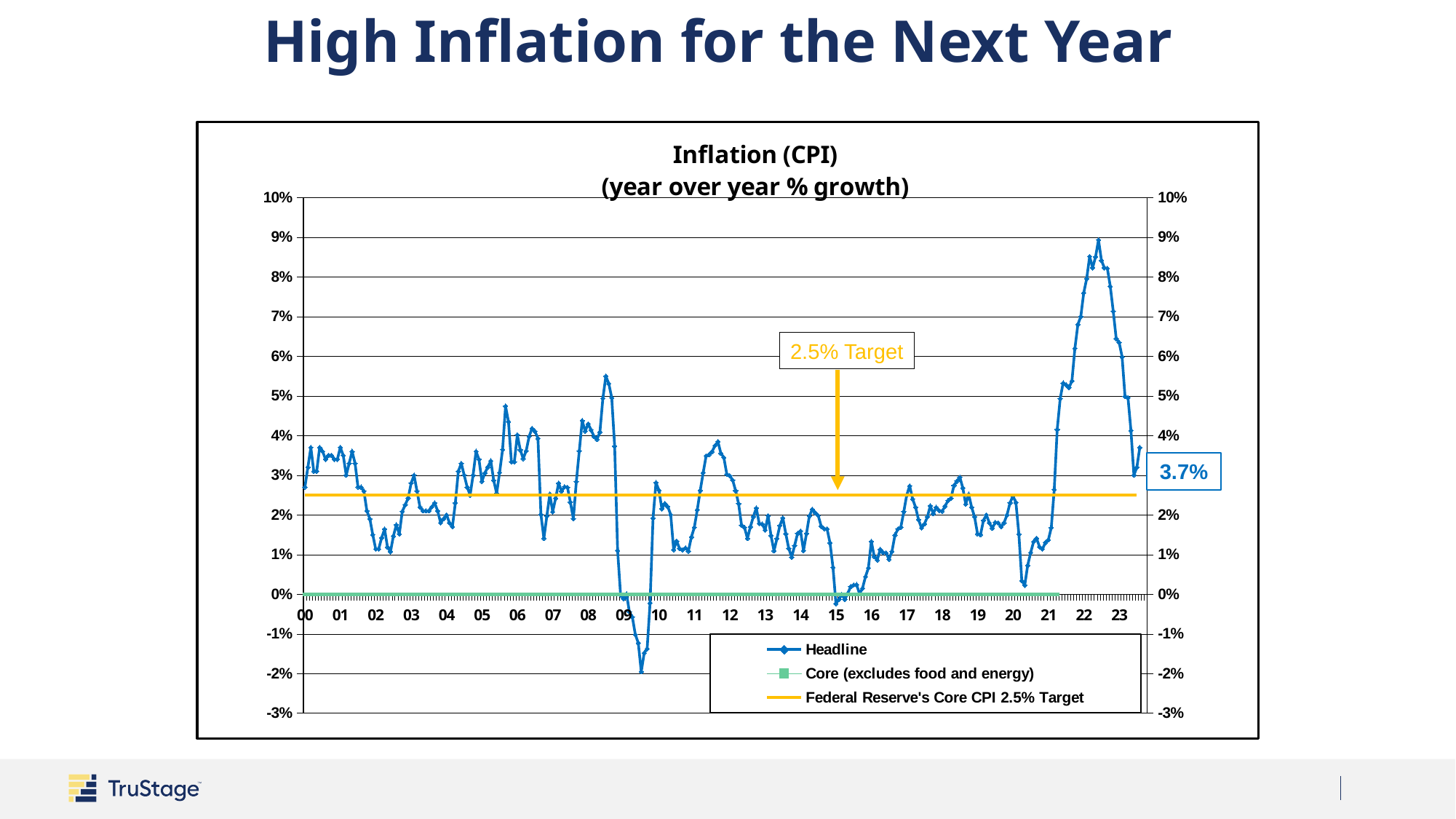
How many series does the chart's legend list? 3 What is the most recent Headline inflation value labelled on the chart? 3.7% What is the Federal Reserve's Core CPI target shown on the chart? 2.5% Does the Headline series rise or fall between its 2022 peak and the end of 2023? fall What is the title of the chart? Inflation (CPI) (year over year % growth) Which is larger, the latest labelled Headline inflation value or the Federal Reserve's target? Headline (3.7%) Is the peak Headline inflation value in 2022 greater or less than 8%? greater What kind of chart is shown on the slide? line chart Is the lowest Headline inflation value in 2009 greater or less than -1%? less In which year does the Headline series reach its highest point? 22 In which year does the Headline series reach its lowest point? 09 By how much does the labelled latest Headline value of 3.7% exceed the 2.5% target? 1.2%